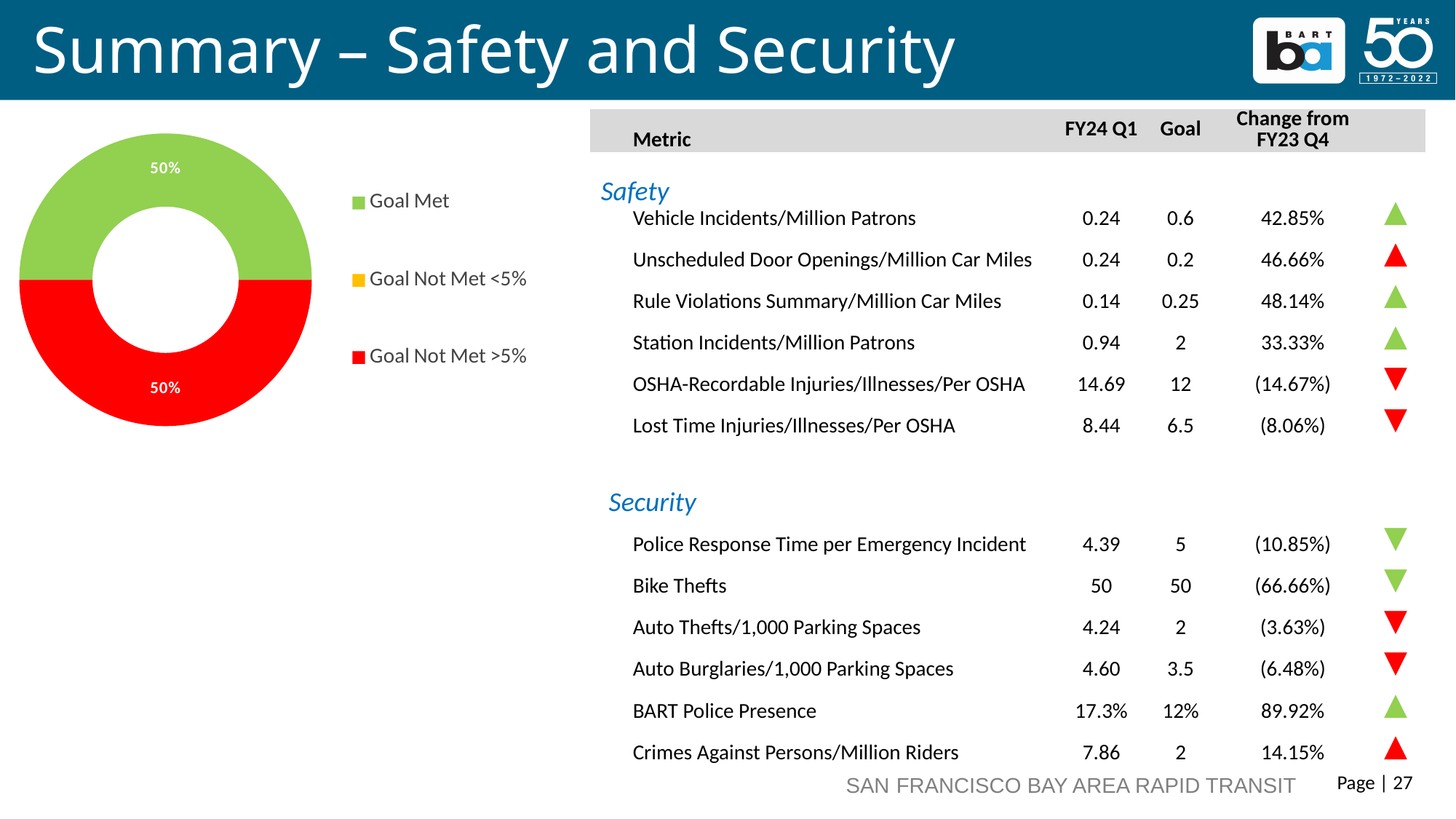
Is the share for "Goal Met" greater or less than 25%? greater What kind of chart is shown on the left of the slide? Pie (donut) chart What colour is the "Goal Met" slice in the donut chart? Green How many entries does the legend of the donut chart list? 3 Which legend entry of the donut chart has no visible slice? Goal Not Met <5% How many slices are visible in the donut chart? 2 What share of the donut chart is labelled "Goal Met"? 50% What share of the donut chart is labelled "Goal Not Met >5%"? 50% What is the combined share of the "Goal Met" and "Goal Not Met >5%" slices? 100%